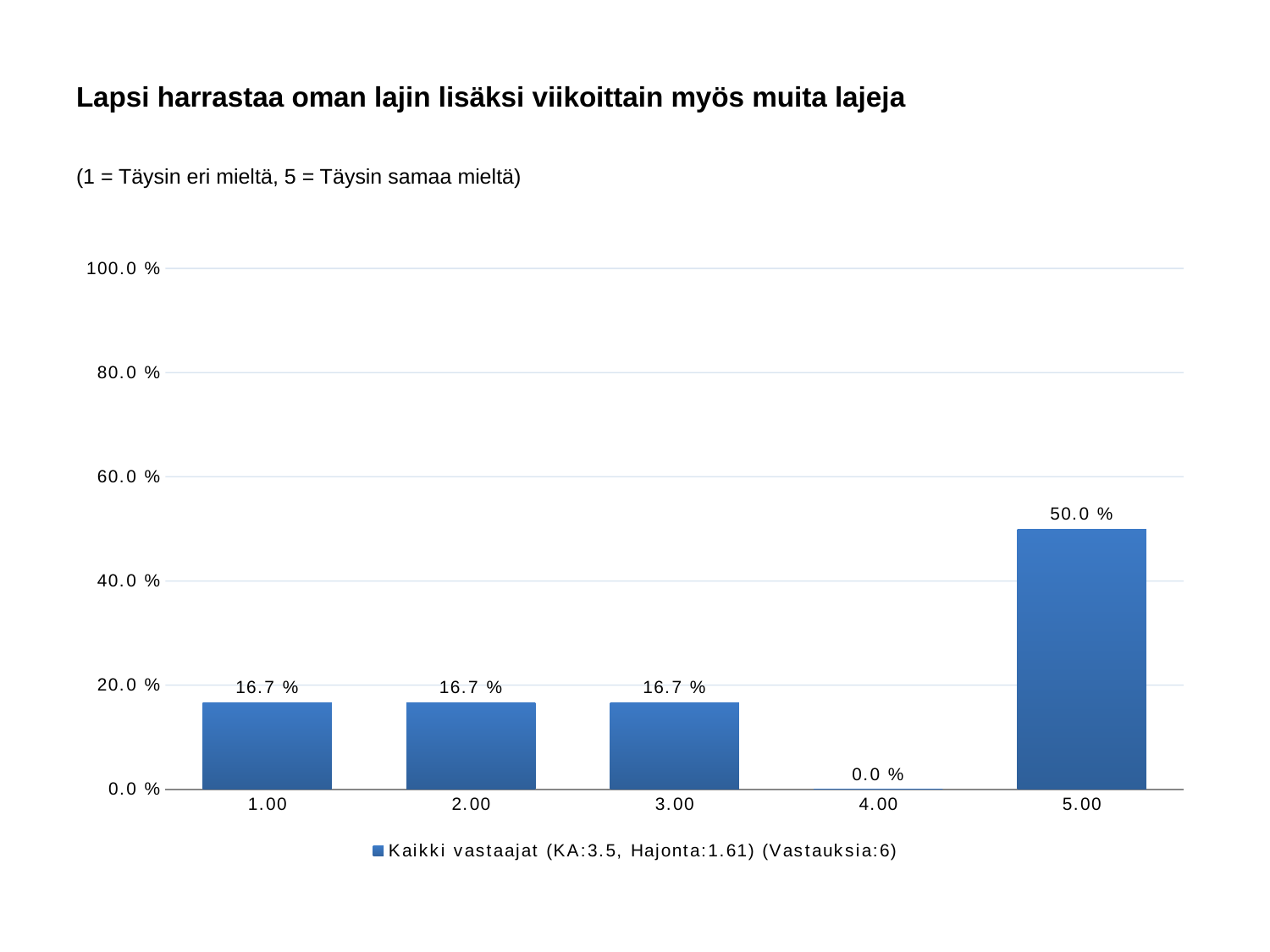
Which is larger, the value for 2.00 or the value for 5.00? 5.00 How many categories are shown on the x axis? 5 What is the value for category 1.00? 16.7 % How many series does the legend list? 1 What is the title of the chart? Lapsi harrastaa oman lajin lisäksi viikoittain myös muita lajeja Which category has the highest value? 5.00 Is the value for 5.00 greater or less than 40.0 %? greater What is the difference between the values for 5.00 and 3.00? 33.3 % Which category has the lowest value? 4.00 What kind of chart is shown? bar chart What is the value for category 4.00? 0.0 % What is the value for category 5.00? 50.0 %